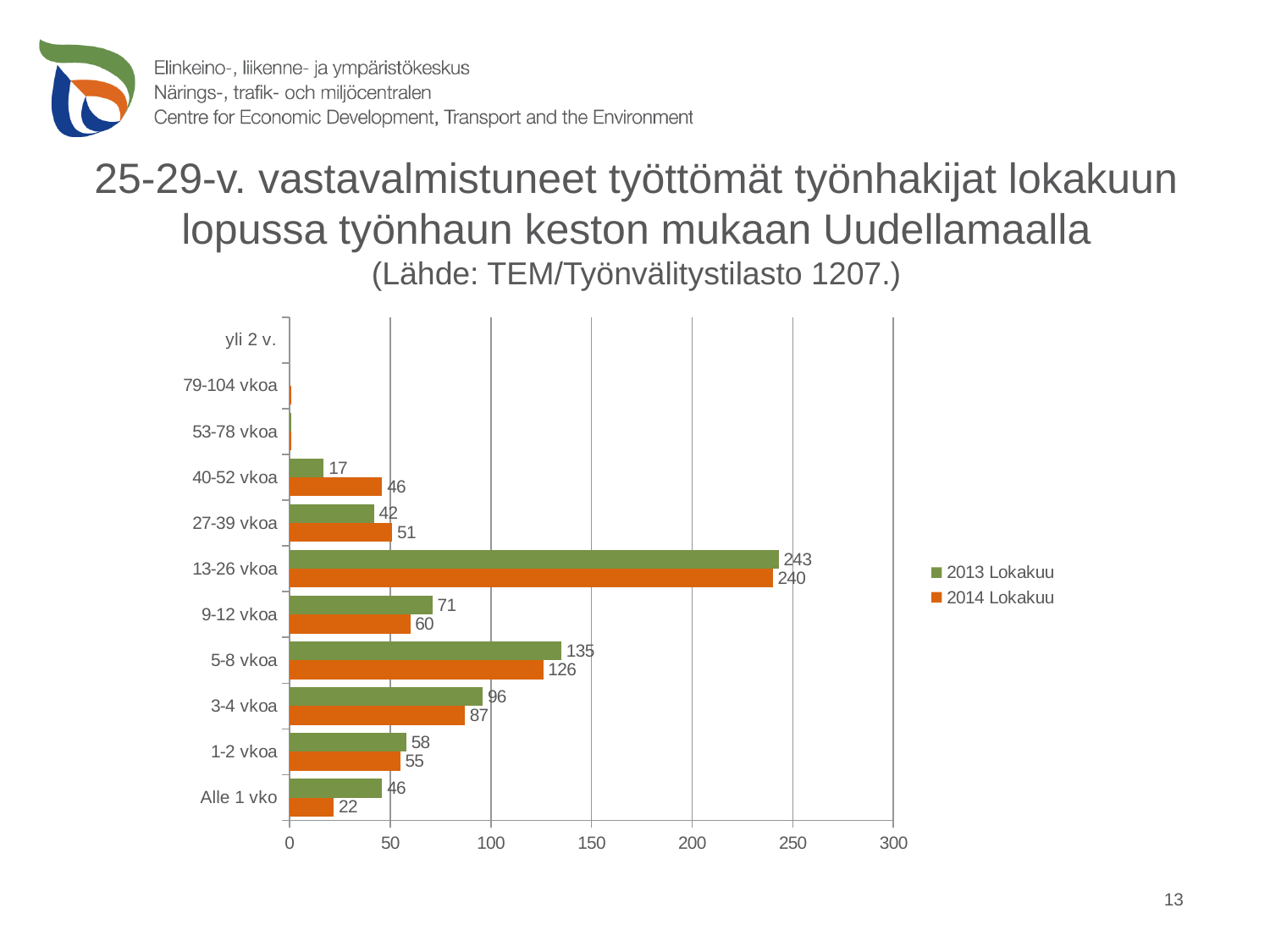
How many series does the legend list? 2 What is the difference between the 2013 Lokakuu and 2014 Lokakuu values for Alle 1 vko? 24 What kind of chart is shown on the slide? bar chart What is the value for 13-26 vkoa in the 2013 Lokakuu series? 243 How many categories are shown on the vertical axis? 11 What colour represents the 2014 Lokakuu series? orange What is the value for 40-52 vkoa in the 2014 Lokakuu series? 46 Which category has the highest value in the 2014 Lokakuu series? 13-26 vkoa Is the 2013 Lokakuu value for 3-4 vkoa greater or less than 50? greater What is the value for Alle 1 vko in the 2014 Lokakuu series? 22 Which is larger for 40-52 vkoa: the 2013 Lokakuu value or the 2014 Lokakuu value? 2014 Lokakuu What is the difference between the 2013 Lokakuu and 2014 Lokakuu values for 5-8 vkoa? 9